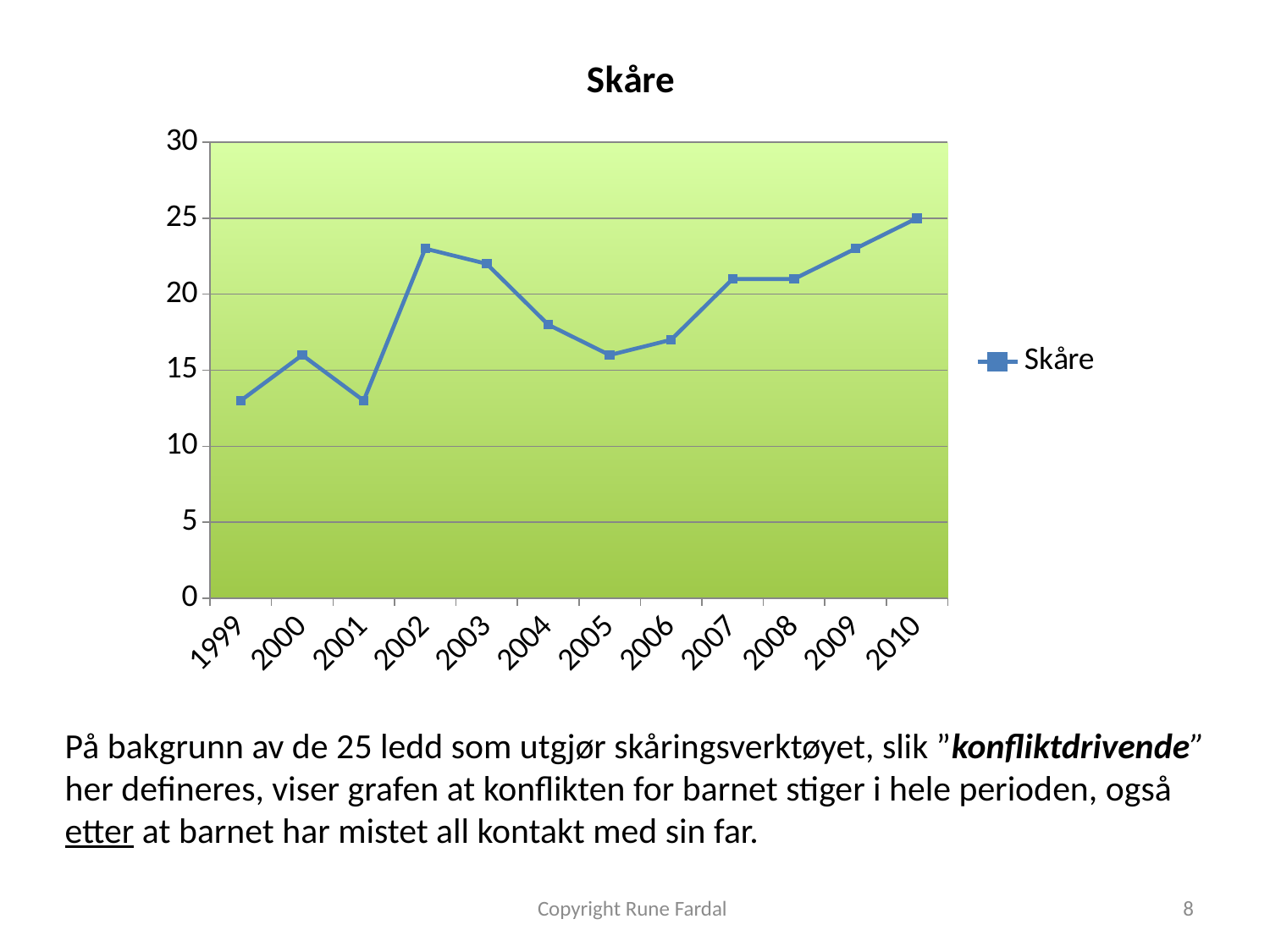
How many series does the legend list? 1 Which year has the larger Skåre value, 2002 or 2004? 2002 What is the Skåre value for 2010? 25 Which year has the highest Skåre value? 2010 What kind of chart is shown on the slide? line chart Is the Skåre value for 2004 greater or less than 20? less Overall, does the Skåre value rise or fall from 1999 to 2010? rise Is the Skåre value for 1999 greater or less than 15? less How many years are plotted along the x axis? 12 Which year has the larger Skåre value, 2000 or 2001? 2000 What is the title of the chart? Skåre Is the Skåre value for 2002 greater or less than 20? greater